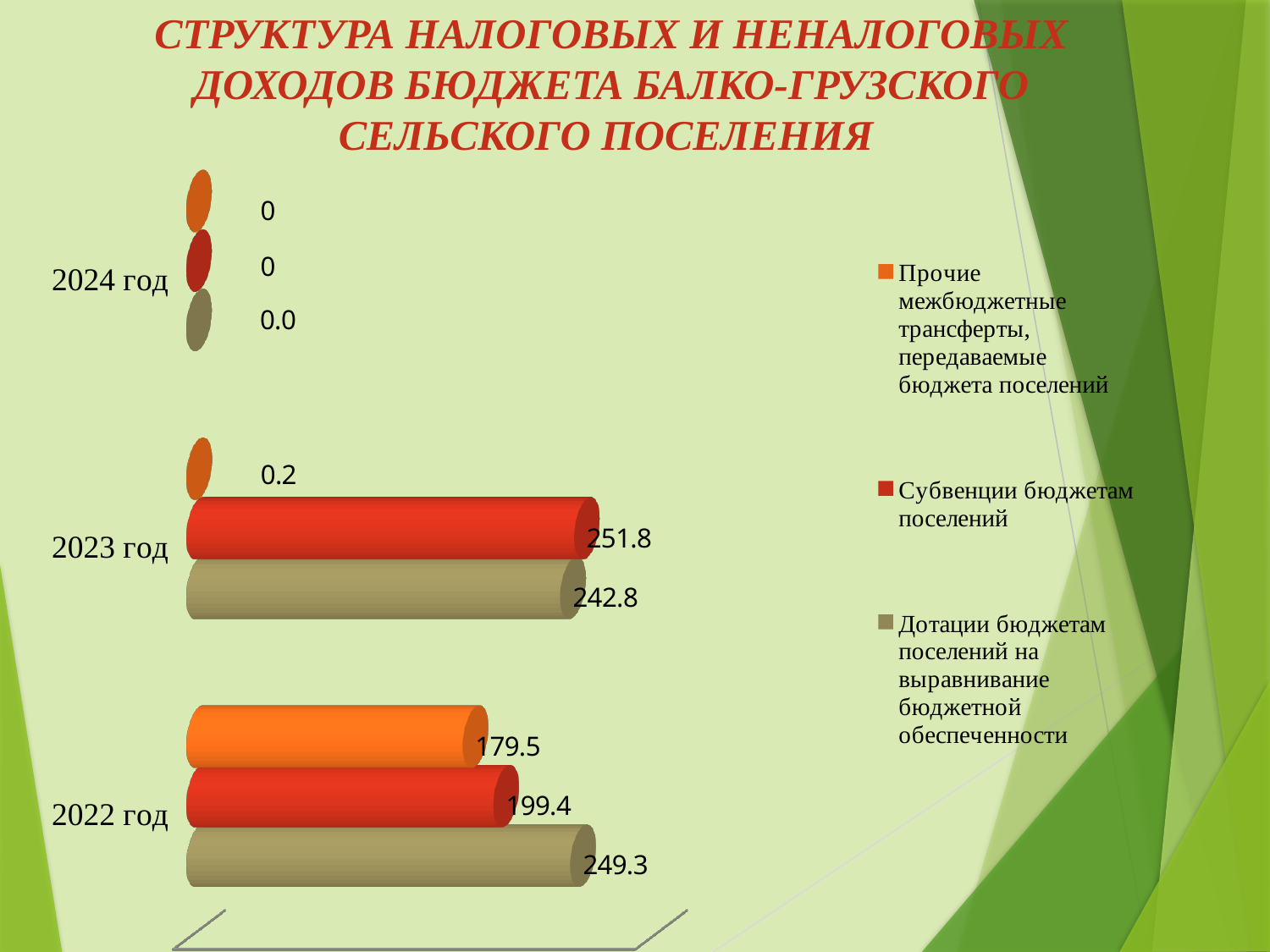
How many series does the legend list? 3 What is the value of Прочие межбюджетные трансферты, передаваемые бюджета поселений for 2022 год? 179.5 What is the value of Субвенции бюджетам поселений for 2022 год? 199.4 What kind of chart is shown on the slide? bar chart What is the value of Дотации бюджетам поселений на выравнивание бюджетной обеспеченности for 2022 год? 249.3 How many year categories are shown on the chart? 3 Which year has the highest value for Субвенции бюджетам поселений? 2023 год What is the value of Субвенции бюджетам поселений for 2023 год? 251.8 Which is larger for 2022 год: Субвенции бюджетам поселений or Прочие межбюджетные трансферты, передаваемые бюджета поселений? Субвенции бюджетам поселений What is the difference between Субвенции бюджетам поселений in 2023 год and 2022 год? 52.4 Which year has the lowest value for Дотации бюджетам поселений на выравнивание бюджетной обеспеченности? 2024 год What is the value of Прочие межбюджетные трансферты, передаваемые бюджета поселений for 2023 год? 0.2